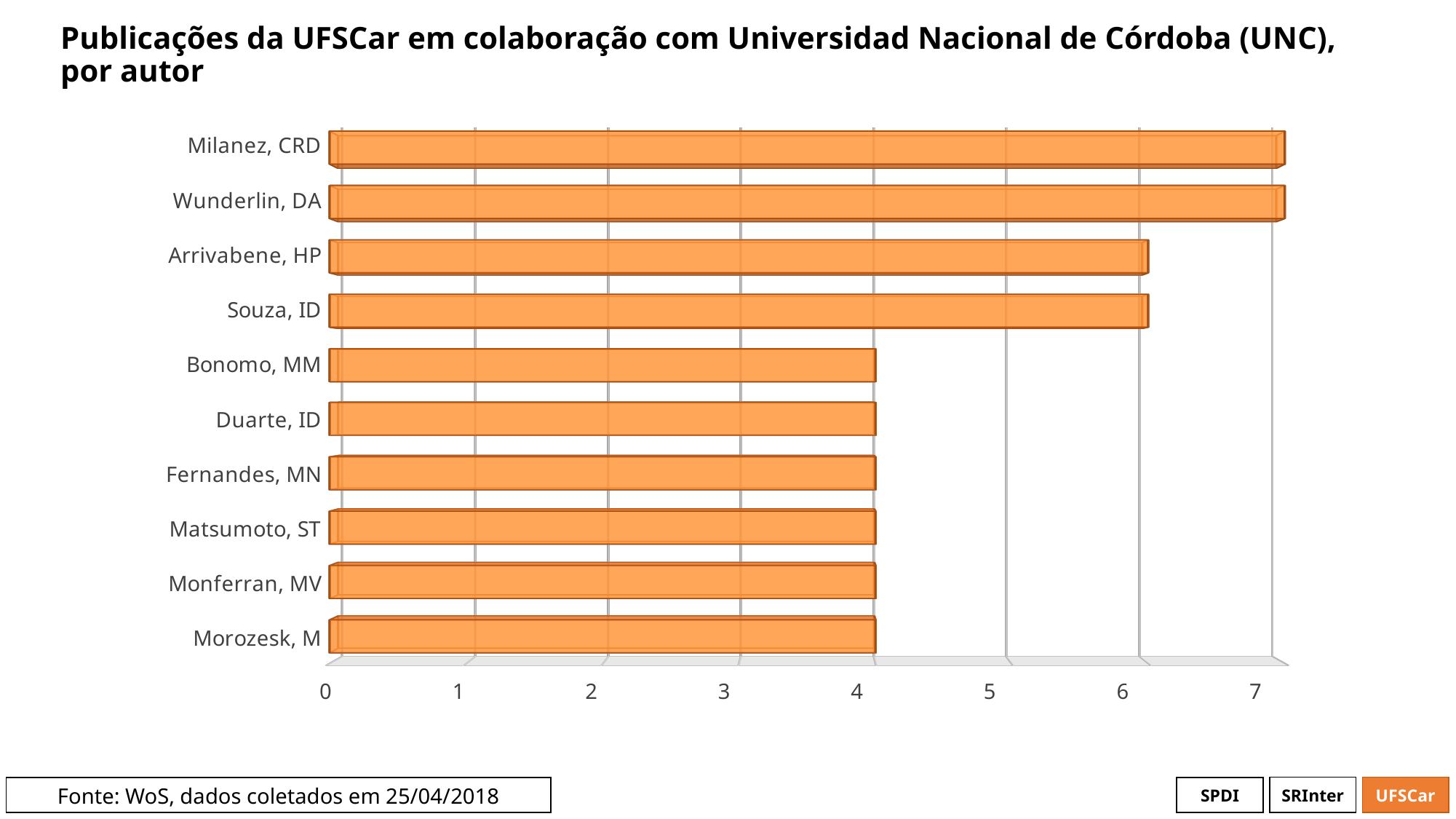
What is the difference between the values for Milanez, CRD and Matsumoto, ST? 3 What is the value for Bonomo, MM? 4 What kind of chart is shown on the slide? bar chart Do the bar values rise or fall going from the top author to the bottom author? fall How many authors are listed in the chart? 10 What is the value for Milanez, CRD? 7 Is the value for Wunderlin, DA greater or less than 6? greater Which has a larger value, Milanez, CRD or Arrivabene, HP? Milanez, CRD Is the value for Morozesk, M greater or less than 5? less What is the value for Arrivabene, HP? 6 What colour are the bars in the chart? orange Which has a larger value, Souza, ID or Duarte, ID? Souza, ID